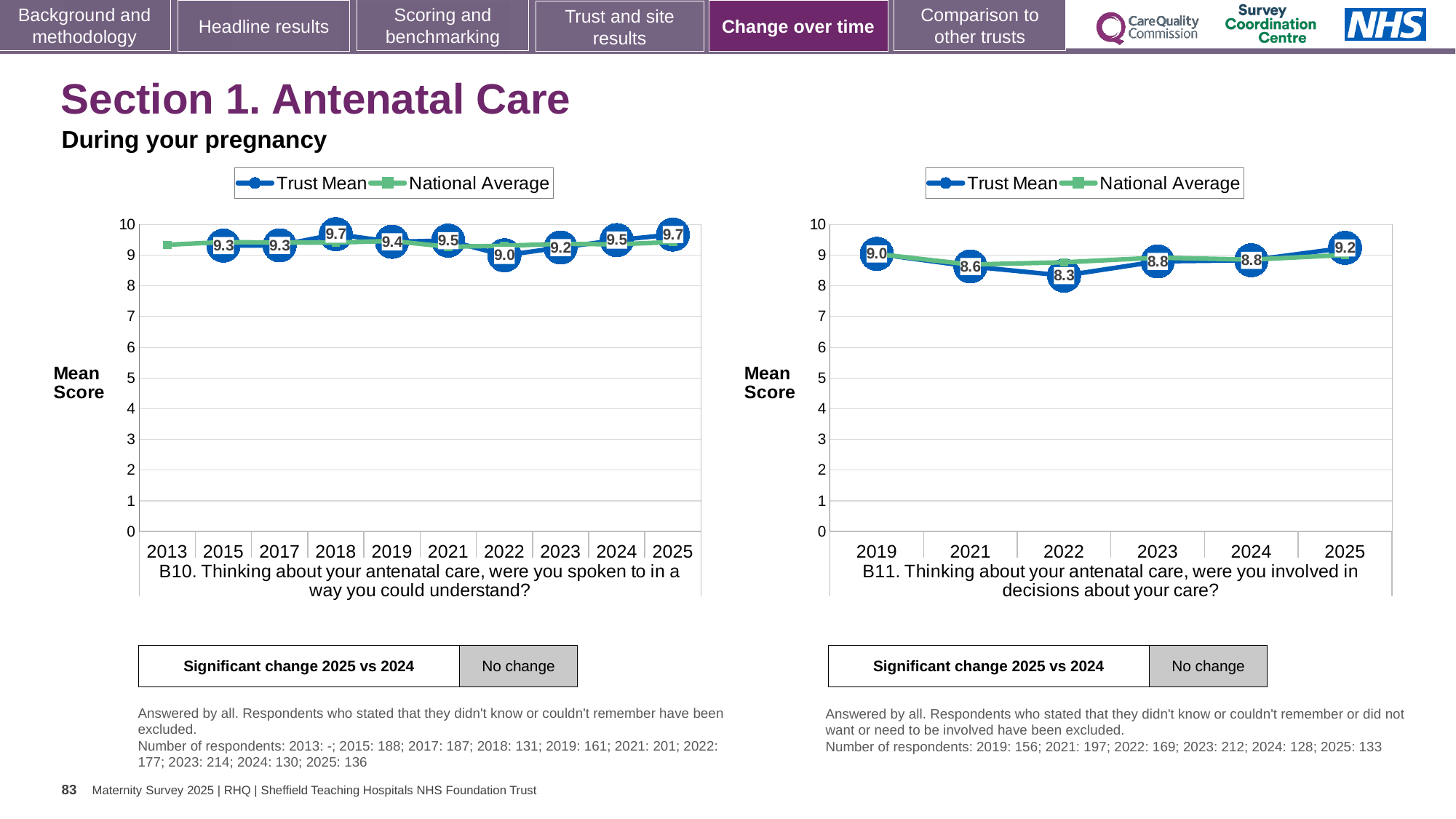
In the B10 chart (left), what is the Trust Mean for 2025? 9.7 In the B10 chart (left), what is the difference between the Trust Mean in 2025 and in 2022? 0.7 In the B10 chart (left), what is the Trust Mean for 2022? 9.0 In the B11 chart (right), is the Trust Mean higher in 2019 or in 2021? 2019 In the B11 chart (right), what is the Trust Mean for 2022? 8.3 In the B10 chart (left), which year has the lowest Trust Mean? 2022 What type of chart is the B11 chart (right)? Line chart In the B11 chart (right), how many series does the legend list? 2 In the B11 chart (right), what is the difference between the Trust Mean in 2025 and in 2022? 0.9 In the B11 chart (right), which year has the lowest Trust Mean? 2022 In the B11 chart (right), which year has the highest Trust Mean? 2025 In the B10 chart (left), how many years are shown on the x axis? 10